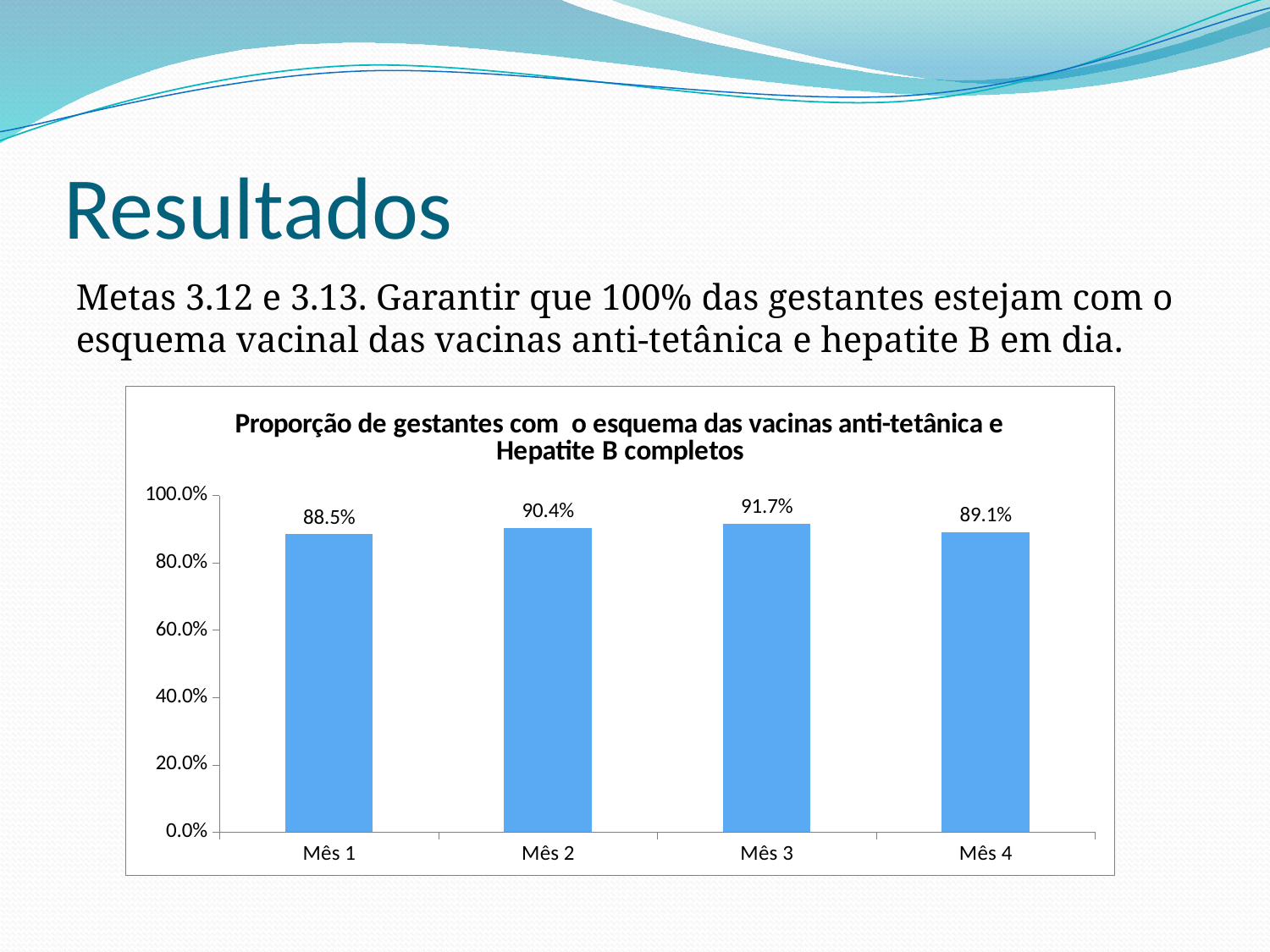
What is the value for Mês 4? 89.1% What is the difference between the values for Mês 3 and Mês 1? 3.2% What is the value for Mês 3? 91.7% What is the difference between the values for Mês 2 and Mês 4? 1.3% What kind of chart is shown on the slide? bar chart Is the value for Mês 2 greater or less than 80.0%? greater What is the value for Mês 1? 88.5% Which month has the highest value? Mês 3 Which is larger, the value for Mês 2 or the value for Mês 4? Mês 2 What is the title of the chart? Proporção de gestantes com o esquema das vacinas anti-tetânica e Hepatite B completos How many months are shown on the x axis? 4 Which month has the lowest value? Mês 1